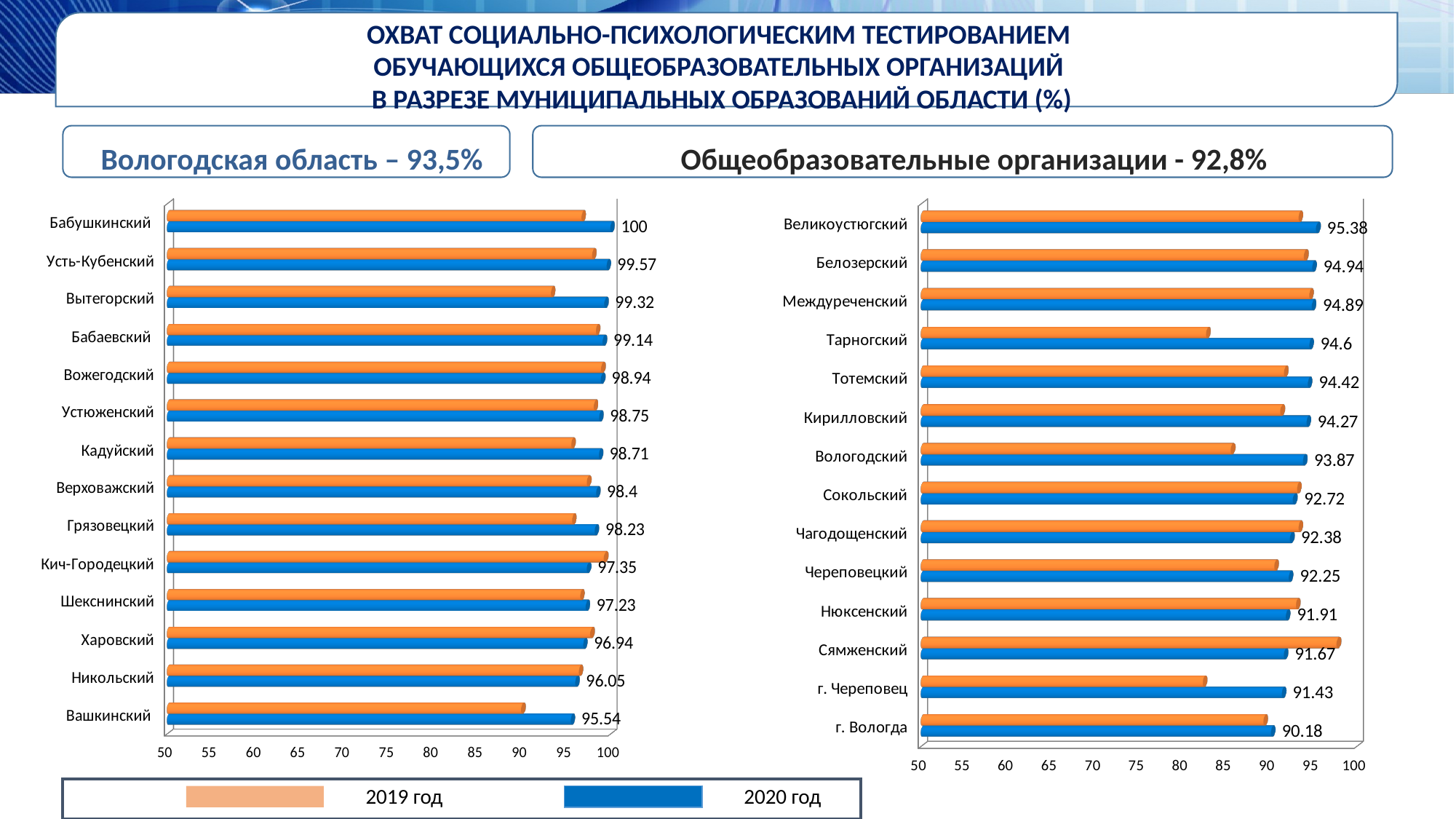
In the left chart, what is the 2020 value for Бабушкинский? 100 In the right chart, which has the larger 2020 value, Тарногский or Тотемский? Тарногский In the right chart, what is the difference between the 2020 values for Великоустюгский and г. Вологда? 5.2 In the left chart, which category has the lowest 2020 value? Вашкинский In the left chart, is the 2019 value for Вытегорский greater or less than 95? less In the right chart, what is the 2020 value for г. Вологда? 90.18 In the left chart, what is the difference between the 2020 values for Бабушкинский and Вашкинский? 4.46 In the right chart, which category has the highest 2020 value? Великоустюгский How many series does the legend list? 2 What type of chart is used on the slide? Bar chart In the right chart, is the 2019 value for г. Череповец greater or less than 85? less How many categories are shown in the left chart? 14